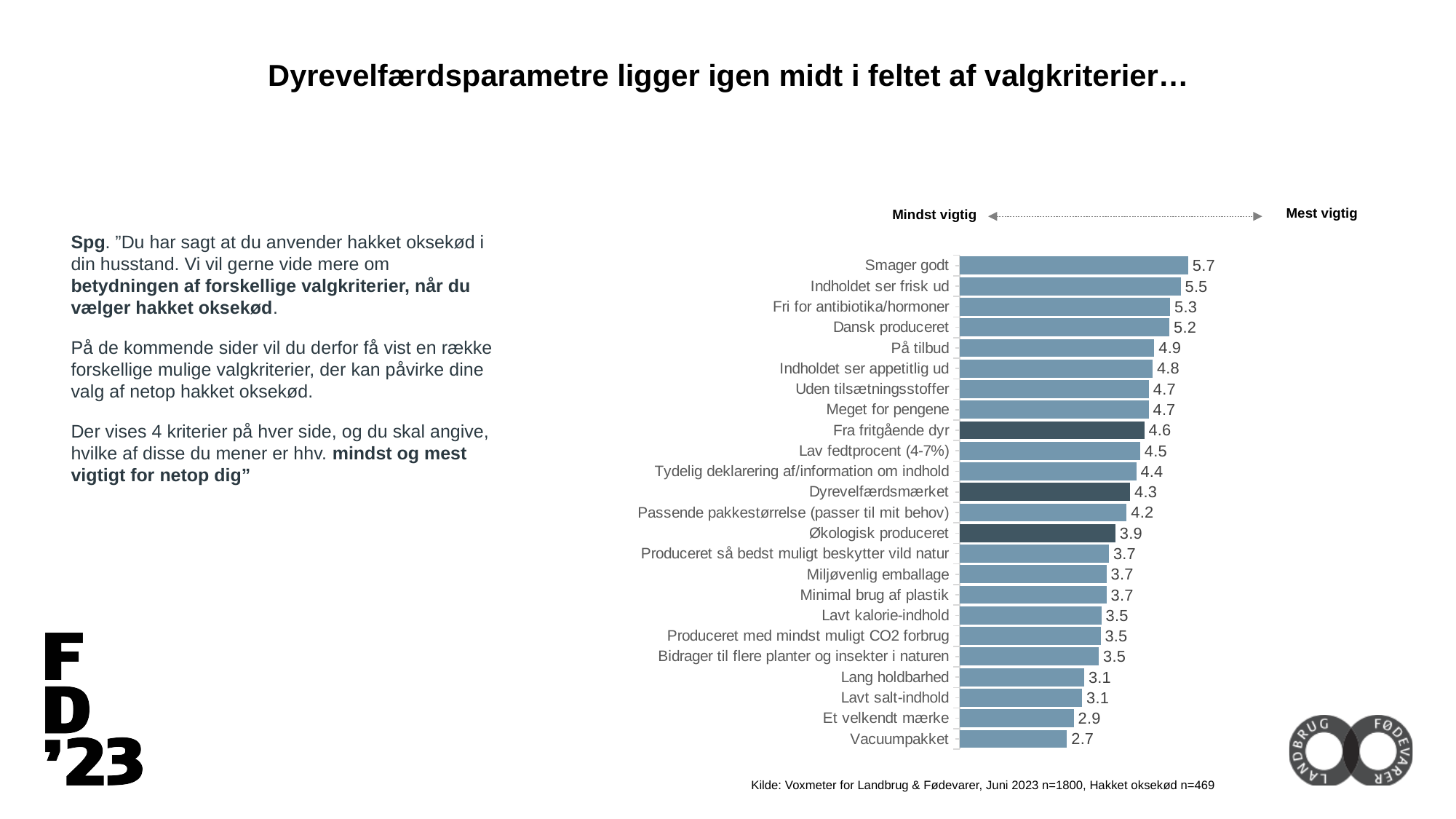
Which three categories are shown with darker bars? Fra fritgående dyr, Dyrevelfærdsmærket, Økologisk produceret What is the difference between the values for "Smager godt" and "Vacuumpakket"? 3.0 Which category has the lowest value? Vacuumpakket Which has a larger value, "På tilbud" or "Lang holdbarhed"? På tilbud What is the value for "Økologisk produceret"? 3.9 What is the value for "Dyrevelfærdsmærket"? 4.3 How many categories are shown in the chart? 24 What is the difference between the values for "Dansk produceret" and "Dyrevelfærdsmærket"? 0.9 What is the value for "Fra fritgående dyr"? 4.6 What kind of chart is shown on the slide? Bar chart Which category has the highest value? Smager godt What is the value for "Smager godt"? 5.7